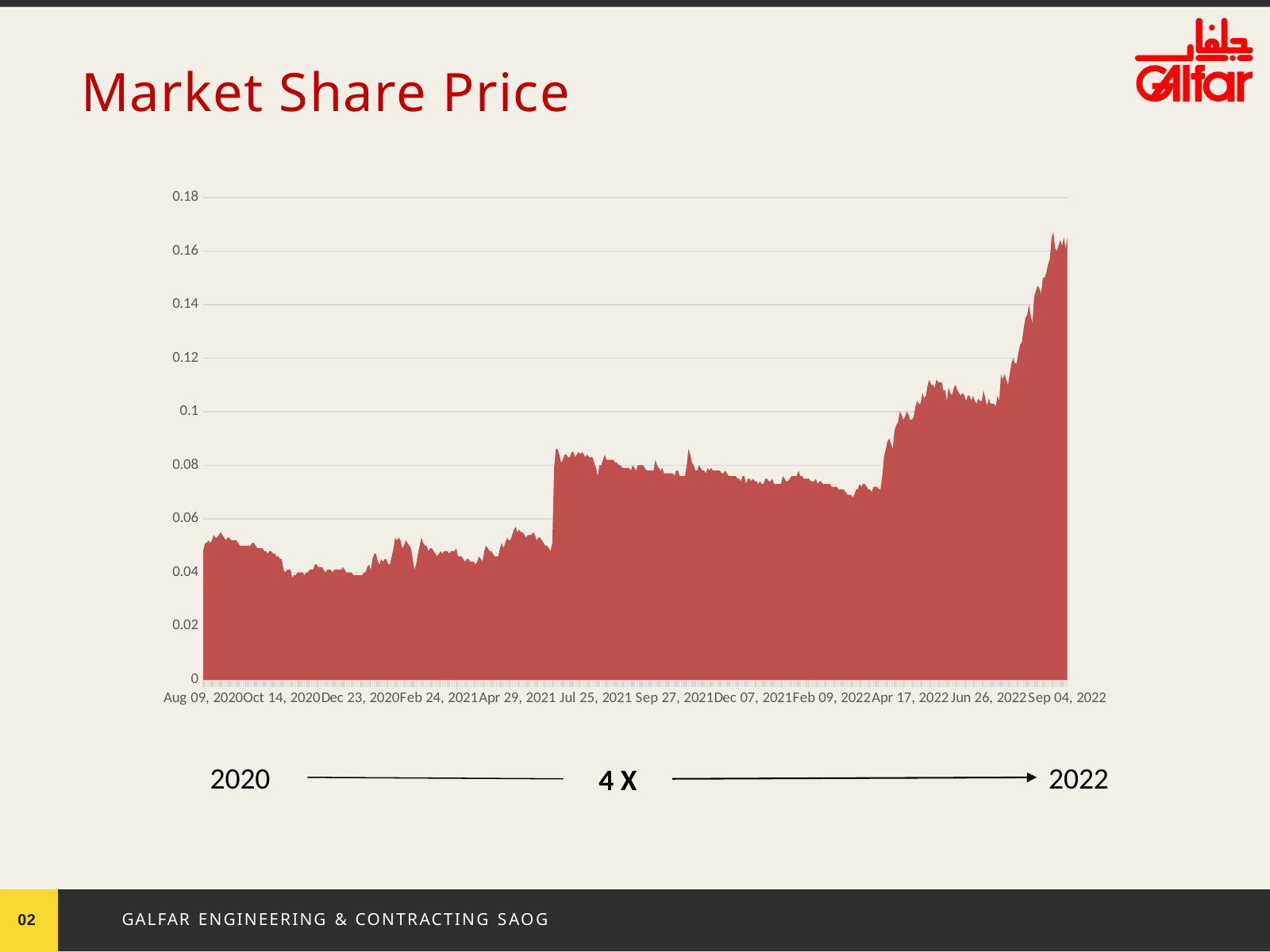
Overall, does the share price rise or fall from Aug 2020 to Sep 2022? rise How many date labels are shown on the x axis? 12 Is the value at Aug 09, 2020 greater or less than 0.06? less What multiplier is annotated below the chart between 2020 and 2022? 4 X Is the value at Feb 09, 2022 greater or less than 0.08? less What kind of chart is shown on the slide? area chart Is the value at Jul 25, 2021 greater or less than 0.06? greater Which is larger, the value at Sep 04, 2022 or the value at Aug 09, 2020? Sep 04, 2022 What is the title of the chart? Market Share Price